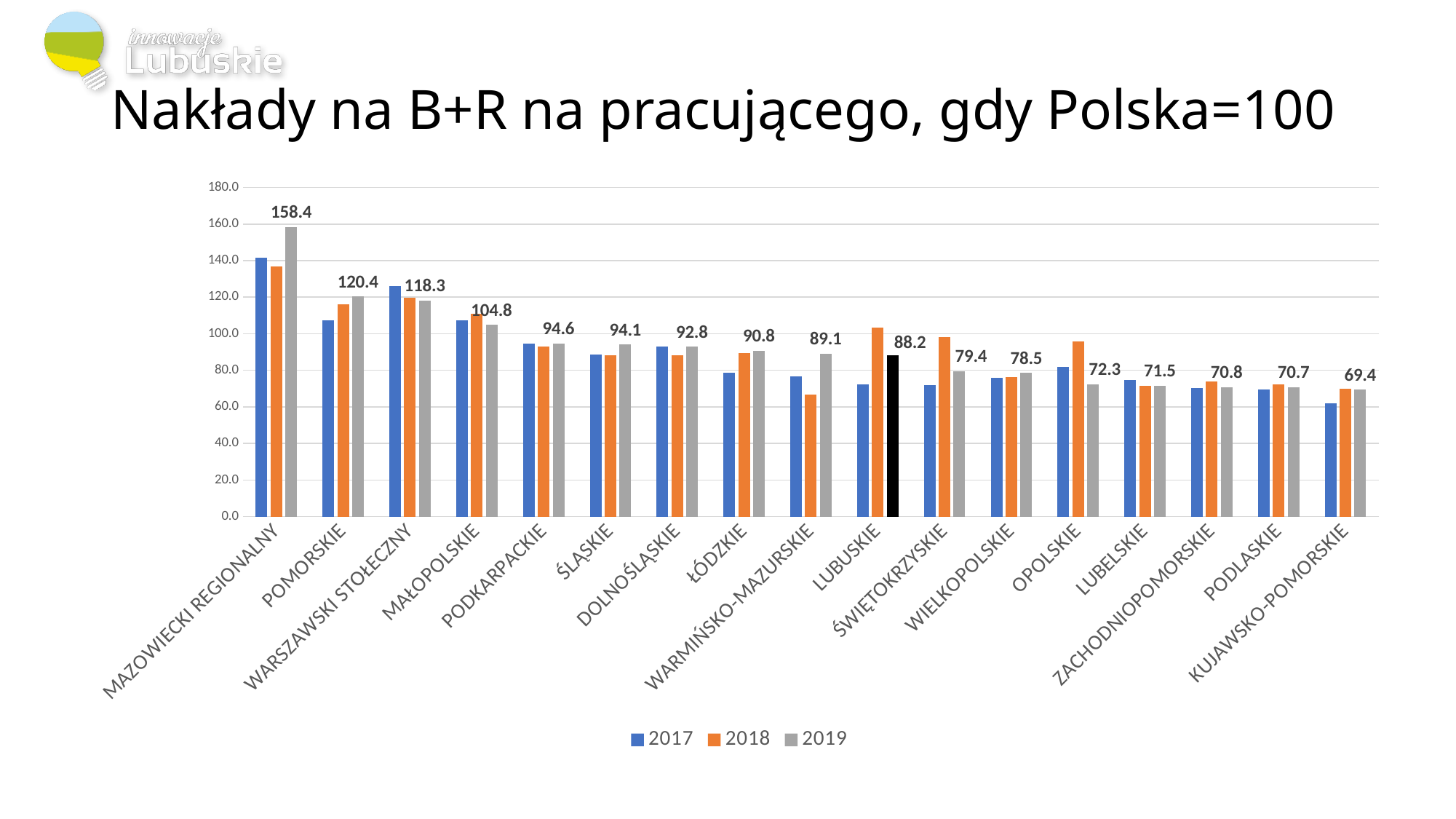
What is the difference between the 2019 values for LUBUSKIE and KUJAWSKO-POMORSKIE? 18.8 Is the 2018 value for OPOLSKIE greater or less than 80? greater How many series does the legend list? 3 Which region has the lowest 2019 value? KUJAWSKO-POMORSKIE Which region has the highest 2019 value? MAZOWIECKI REGIONALNY Is the 2018 value for WARMIŃSKO-MAZURSKIE greater or less than 80? less What is the 2019 value for MAZOWIECKI REGIONALNY? 158.4 What is the 2019 value for POMORSKIE? 120.4 Which has the larger 2019 value, MAŁOPOLSKIE or PODKARPACKIE? MAŁOPOLSKIE What is the 2019 value for LUBUSKIE? 88.2 What kind of chart is shown on the slide? bar chart How many regions are shown on the x axis? 17